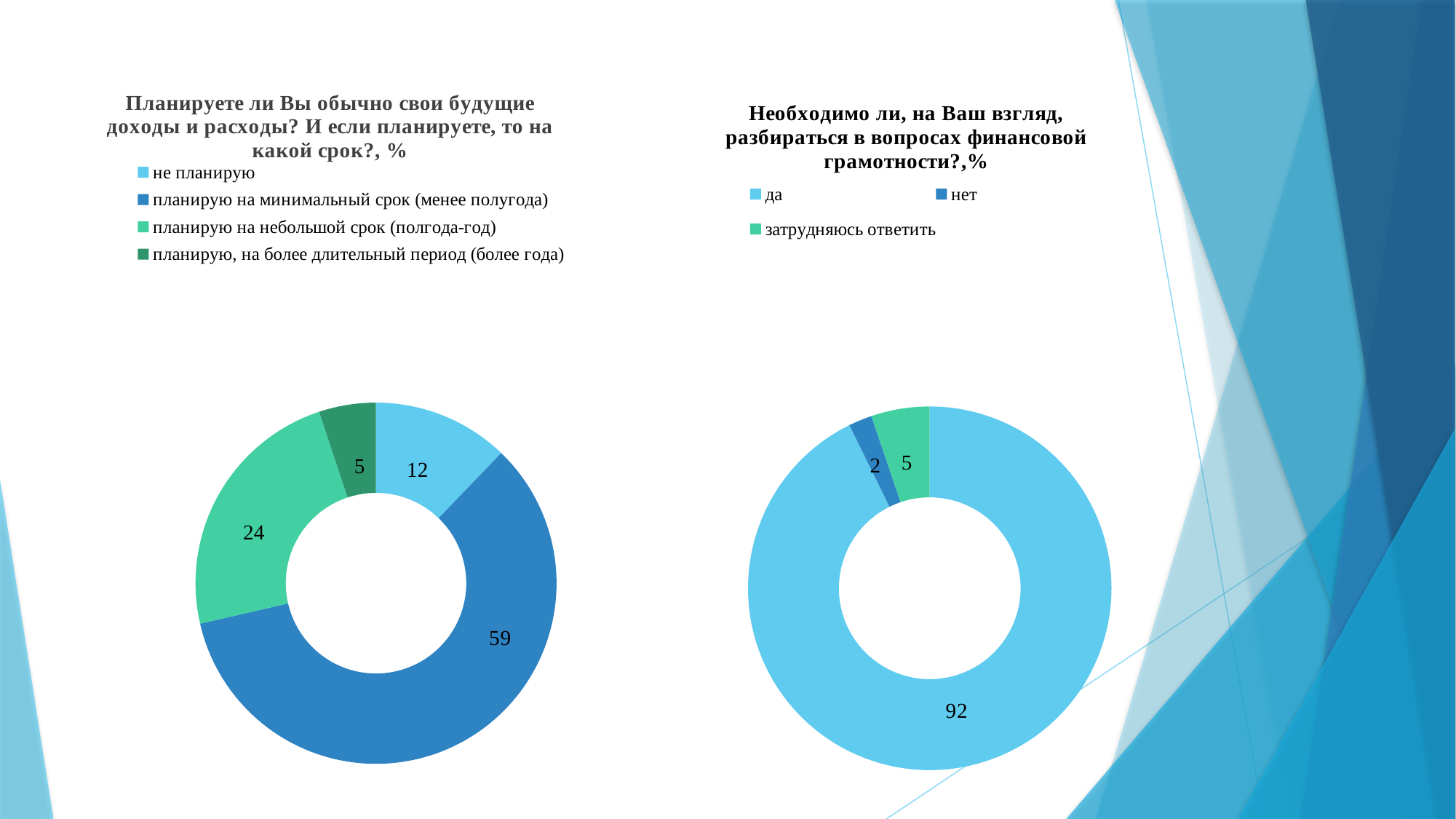
In the left chart (Планируете ли Вы обычно свои будущие доходы и расходы?), what is the value for 'не планирую'? 12 In the left chart (Планируете ли Вы обычно свои будущие доходы и расходы?), which category has the largest share? планирую на минимальный срок (менее полугода) In the left chart (Планируете ли Вы обычно свои будущие доходы и расходы?), how many categories does the legend list? 4 In the left chart (Планируете ли Вы обычно свои будущие доходы и расходы?), what is the value for 'планирую на минимальный срок (менее полугода)'? 59 In the right chart (Необходимо ли, на Ваш взгляд, разбираться в вопросах финансовой грамотности?), what is the value for 'да'? 92 In the left chart (Планируете ли Вы обычно свои будущие доходы и расходы?), which category has the smallest share? планирую, на более длительный период (более года) In the left chart (Планируете ли Вы обычно свои будущие доходы и расходы?), what is the difference between 'планирую на небольшой срок (полгода-год)' and 'не планирую'? 12 In the right chart (Необходимо ли, на Ваш взгляд, разбираться в вопросах финансовой грамотности?), which is larger, 'нет' or 'затрудняюсь ответить'? затрудняюсь ответить In the right chart (Необходимо ли, на Ваш взгляд, разбираться в вопросах финансовой грамотности?), how many categories does the legend list? 3 What kind of chart is the right chart (Необходимо ли, на Ваш взгляд, разбираться в вопросах финансовой грамотности?)? Doughnut chart In the right chart (Необходимо ли, на Ваш взгляд, разбираться в вопросах финансовой грамотности?), what is the difference between 'да' and 'затрудняюсь ответить'? 87 In the right chart (Необходимо ли, на Ваш взгляд, разбираться в вопросах финансовой грамотности?), what is the value for 'нет'? 2